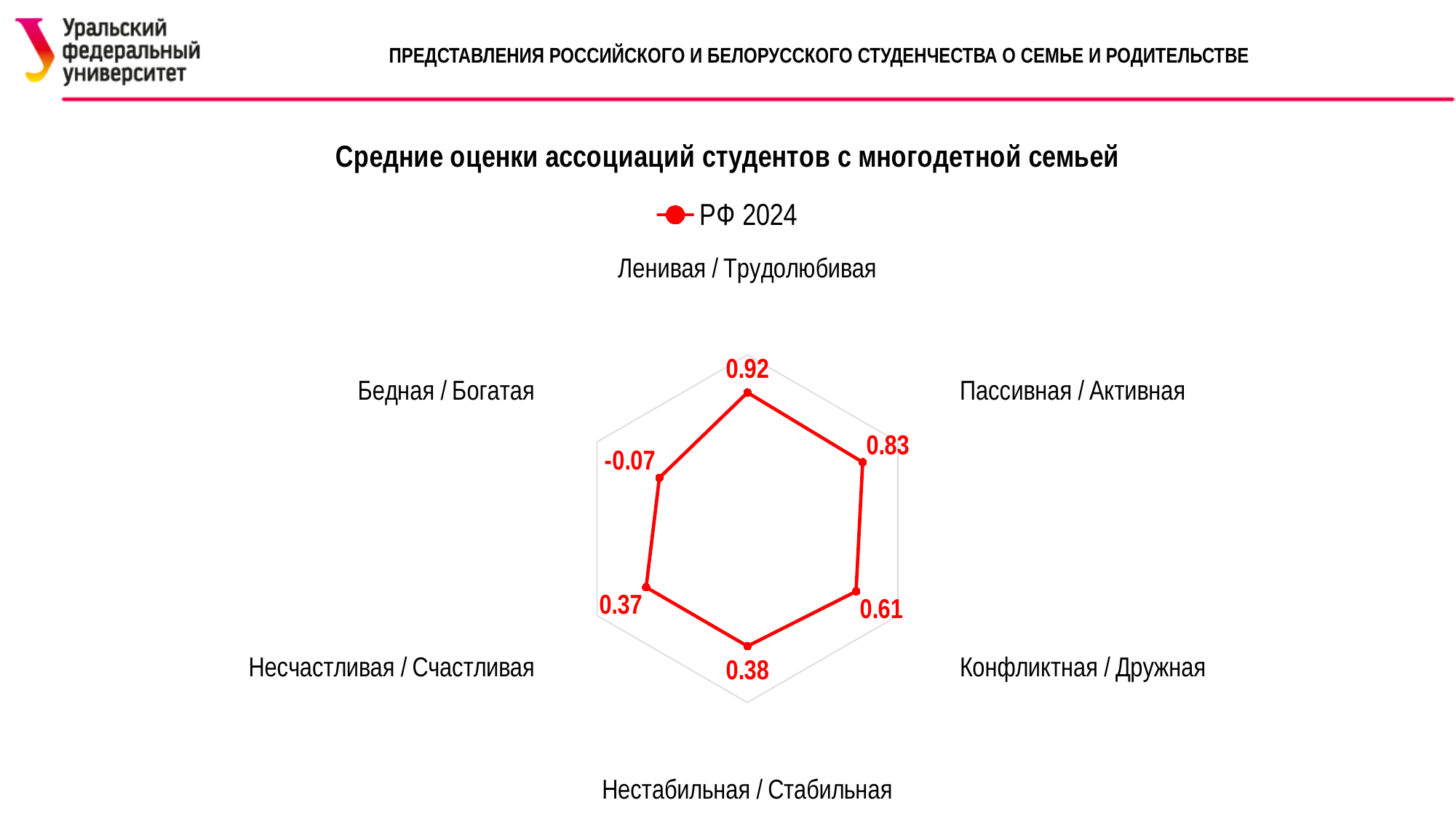
How many categories does the chart have? 6 What is the value for Бедная / Богатая? -0.07 Which category has the lowest value? Бедная / Богатая Which category has the highest value? Ленивая / Трудолюбивая How many series does the legend list? 1 What is the value for Ленивая / Трудолюбивая? 0.92 What is the value for Пассивная / Активная? 0.83 What is the difference between the values for Ленивая / Трудолюбивая and Пассивная / Активная? 0.09 Which is larger, the value for Пассивная / Активная or the value for Конфликтная / Дружная? Пассивная / Активная What kind of chart is shown on the slide? Radar chart What is the value for Конфликтная / Дружная? 0.61 What is the difference between the values for Конфликтная / Дружная and Нестабильная / Стабильная? 0.23